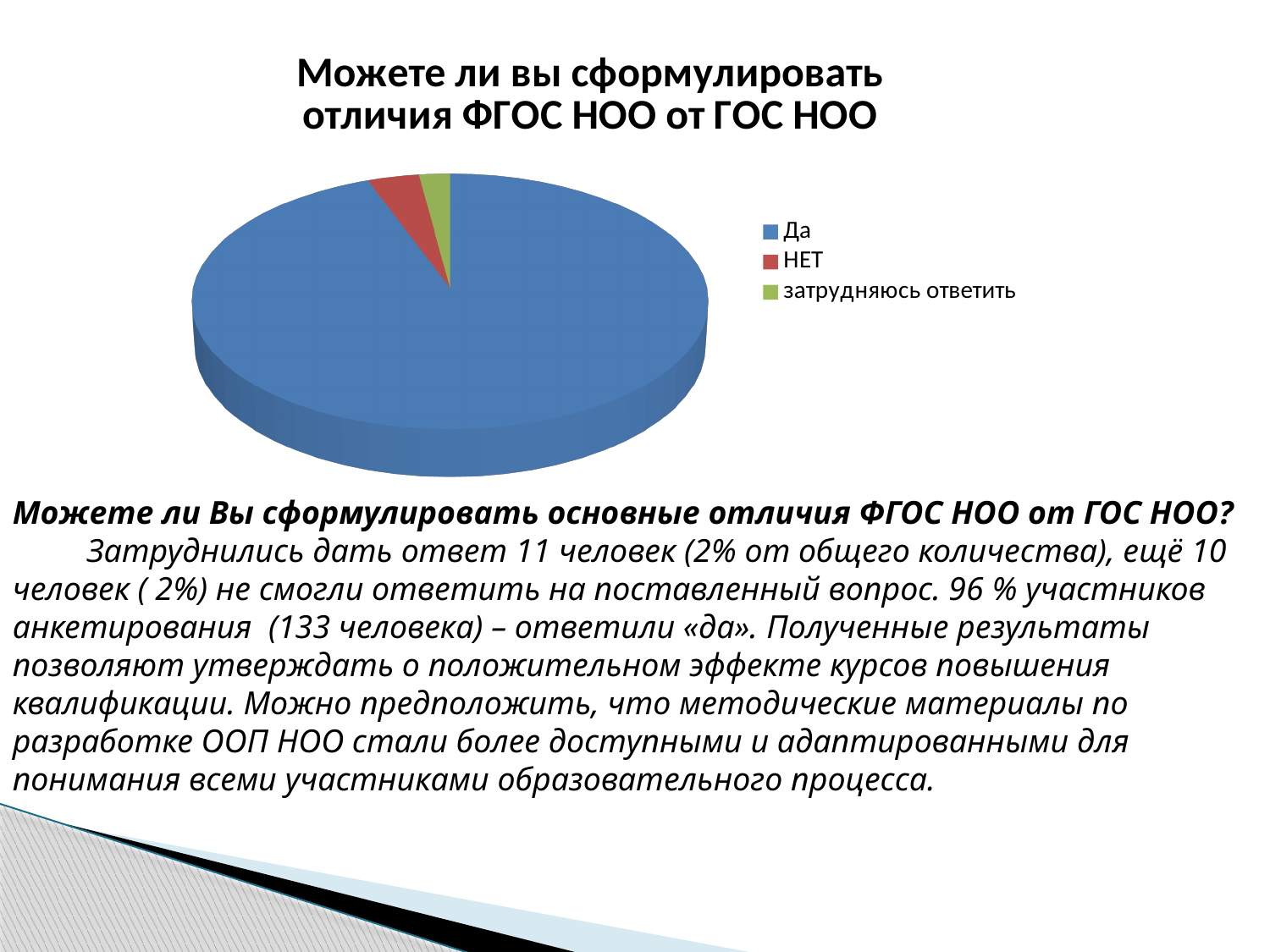
How many entries does the legend of the pie chart list? 3 Which slice is larger in the pie chart, Да or затрудняюсь ответить? Да What kind of chart is shown on the slide? pie chart What is the title of the chart on the slide? Можете ли вы сформулировать отличия ФГОС НОО от ГОС НОО Which category has the largest slice in the pie chart? Да What colour is the Да slice in the pie chart? blue How many slices does the pie chart have? 3 Which slice is larger in the pie chart, Да or НЕТ? Да